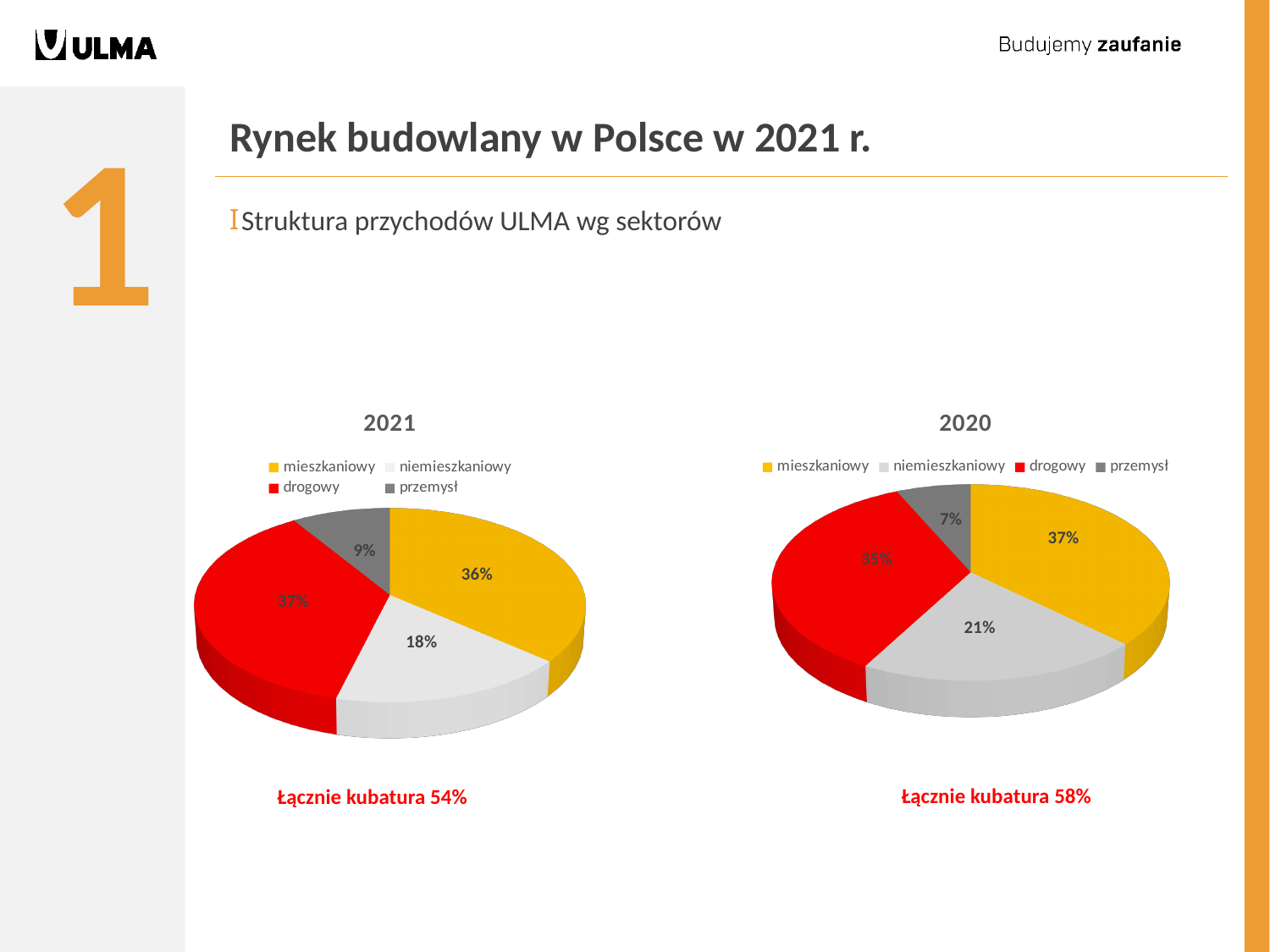
In the 2020 pie chart, which sector has the smallest share? przemysł What is the title of the chart on the left side of the slide? 2021 How many sectors are shown in the 2021 pie chart? 4 What type of chart is used for the 2020 data? Pie chart In the 2020 pie chart, which is larger: the niemieszkaniowy share or the przemysł share? niemieszkaniowy In the 2021 pie chart, which sector has the smallest share? przemysł In the 2021 pie chart, what is the difference between the drogowy share and the niemieszkaniowy share? 19 percentage points In the 2020 pie chart, what share does the przemysł sector have? 7% In the 2020 pie chart, which sector has the largest share? mieszkaniowy In the 2021 pie chart, what share does the niemieszkaniowy sector have? 18% In the 2021 pie chart, what share does the mieszkaniowy sector have? 36% In the 2020 pie chart, what share does the drogowy sector have? 35%